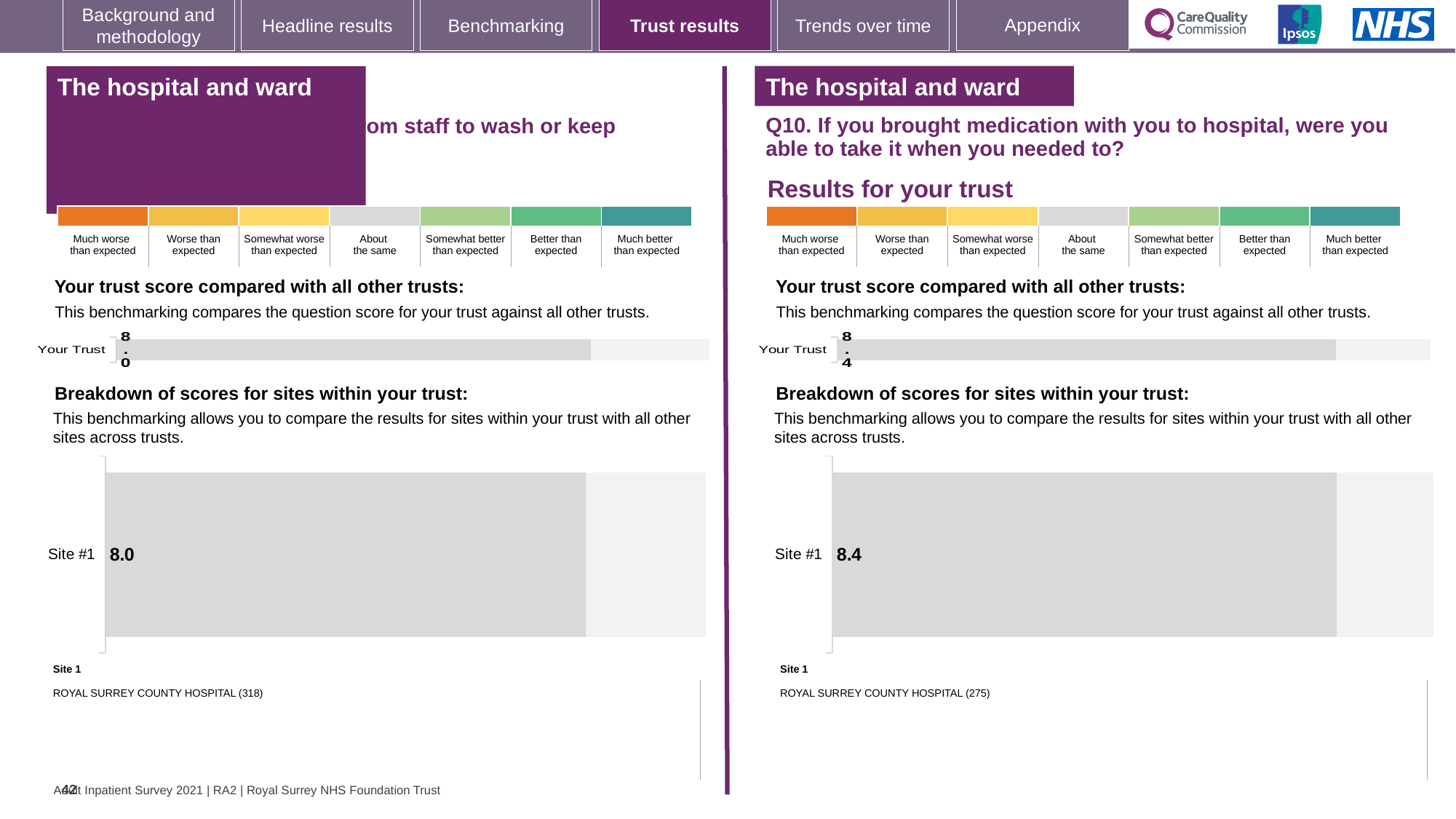
What kind of chart is used to show the breakdown of scores for sites within your trust on the right-hand Q10 chart? Bar chart On the left-hand chart, what score is shown for Site #1 in the breakdown of scores for sites within your trust? 8.0 What is the difference between the Site #1 score on the right-hand Q10 chart and the Site #1 score on the left-hand chart? 0.4 On the right-hand Q10 chart, which site is listed as Site 1 below the breakdown chart? ROYAL SURREY COUNTY HOSPITAL (275) How many sites are shown in the breakdown of scores for sites within your trust on the left-hand chart? 1 On the right-hand chart for Q10 (medication brought to hospital), what is the score shown for Your Trust? 8.4 On the left-hand chart, what is the score shown for Your Trust? 8.0 How many sites are shown in the breakdown of scores for sites within your trust on the right-hand Q10 chart? 1 Which is larger: the Site #1 score on the left-hand chart or the Site #1 score on the right-hand Q10 chart? Right-hand Q10 chart (8.4) On the right-hand chart for Q10, what score is shown for Site #1 in the breakdown of scores for sites within your trust? 8.4 On the left-hand chart, which site is listed as Site 1 below the breakdown chart? ROYAL SURREY COUNTY HOSPITAL (318)